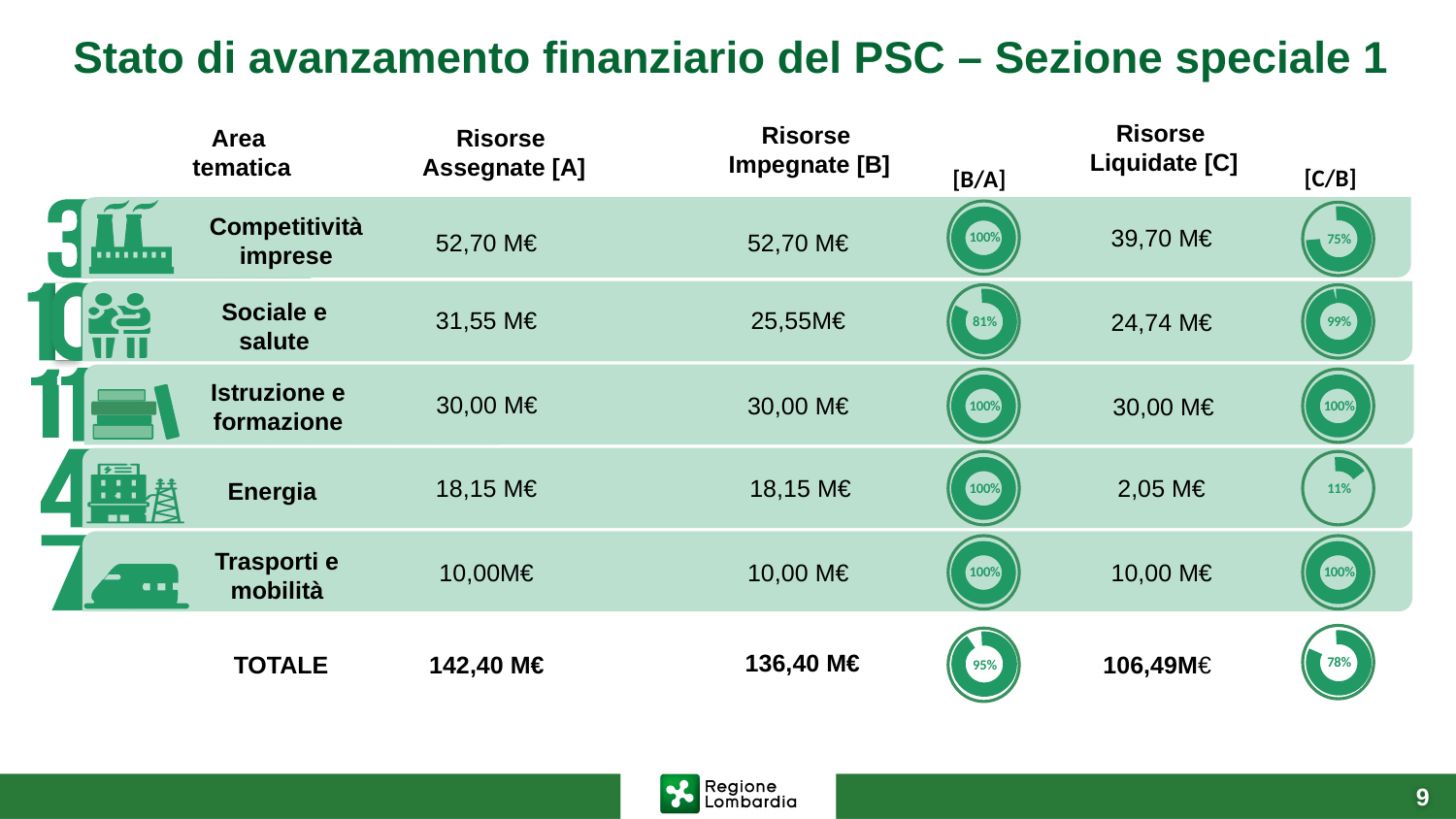
In the [B/A] column, what percentage does the donut chart for Sociale e salute show? 81% In the [C/B] column, is the donut chart percentage for Sociale e salute larger or smaller than that for Competitività imprese? larger In the [C/B] column, what percentage does the donut chart for Energia show? 11% In the [B/A] column, which thematic area has the lowest percentage in its donut chart? Sociale e salute What kind of chart is used to show the [B/A] and [C/B] percentages? Donut (pie) chart In the [C/B] column, which thematic area has the lowest percentage in its donut chart? Energia How many thematic areas show 100% in the [C/B] donut charts? 2 In the [C/B] column, what percentage does the donut chart for the TOTALE row show? 78% In the [C/B] column, what percentage does the donut chart for Competitività imprese show? 75% What is the difference between the [C/B] donut percentages for Sociale e salute and Energia? 88% In the [B/A] column, what percentage does the donut chart for the TOTALE row show? 95% How many thematic areas (excluding the TOTALE row) have a donut chart in the [B/A] column? 5